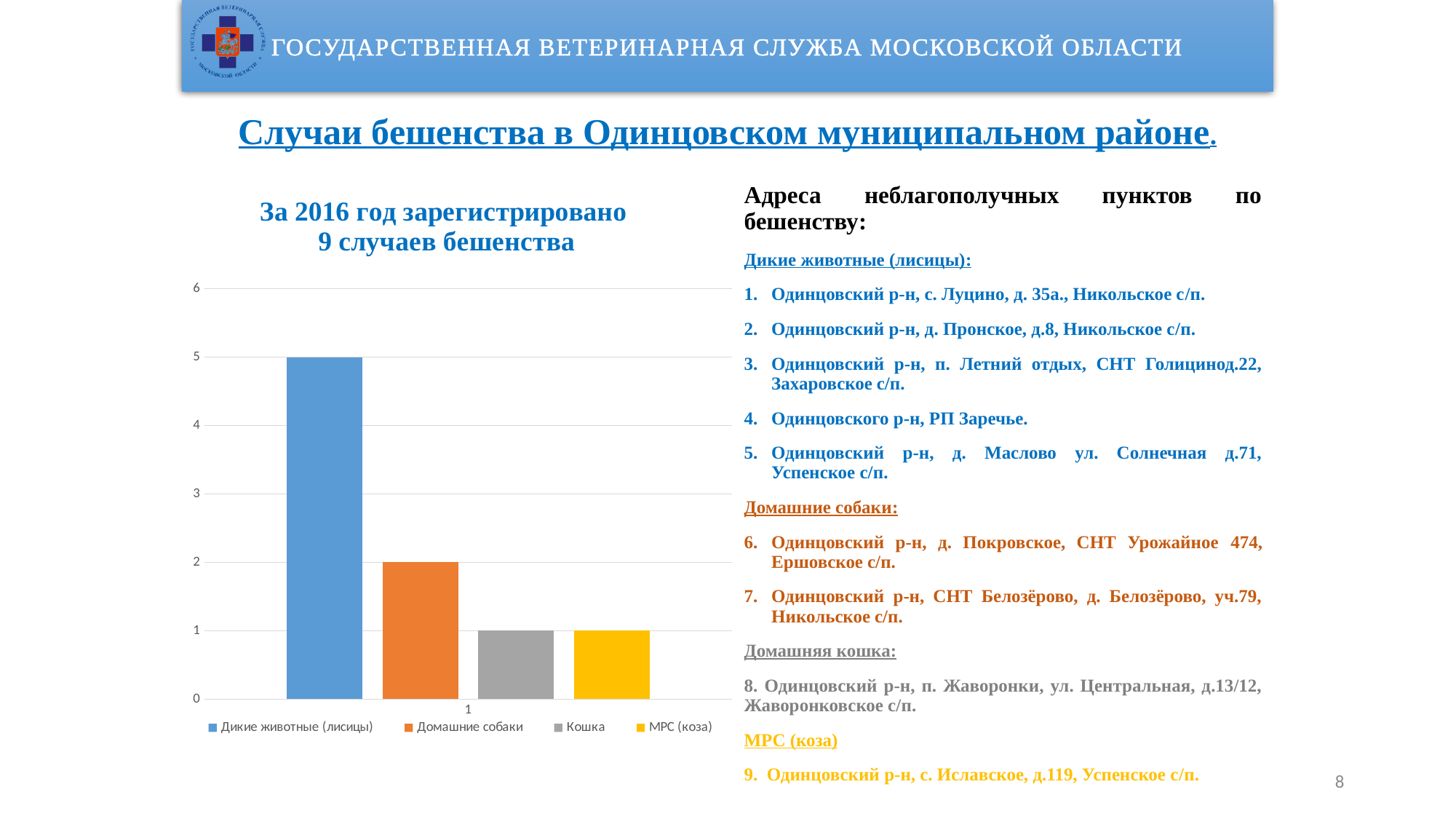
What is the value for Домашние собаки? 2 Which is larger, the value for Домашние собаки or the value for Кошка? Домашние собаки What is the value for Кошка? 1 Is the value for Дикие животные (лисицы) greater or less than 4? greater How many series does the legend list? 4 What colour is the bar for Домашние собаки? orange What kind of chart is shown on the slide? bar chart Which series has the highest value? Дикие животные (лисицы) What is the difference between the values for Дикие животные (лисицы) and Домашние собаки? 3 What is the value for МРС (коза)? 1 What is the value for Дикие животные (лисицы)? 5 What is the title of the chart? За 2016 год зарегистрировано 9 случаев бешенства